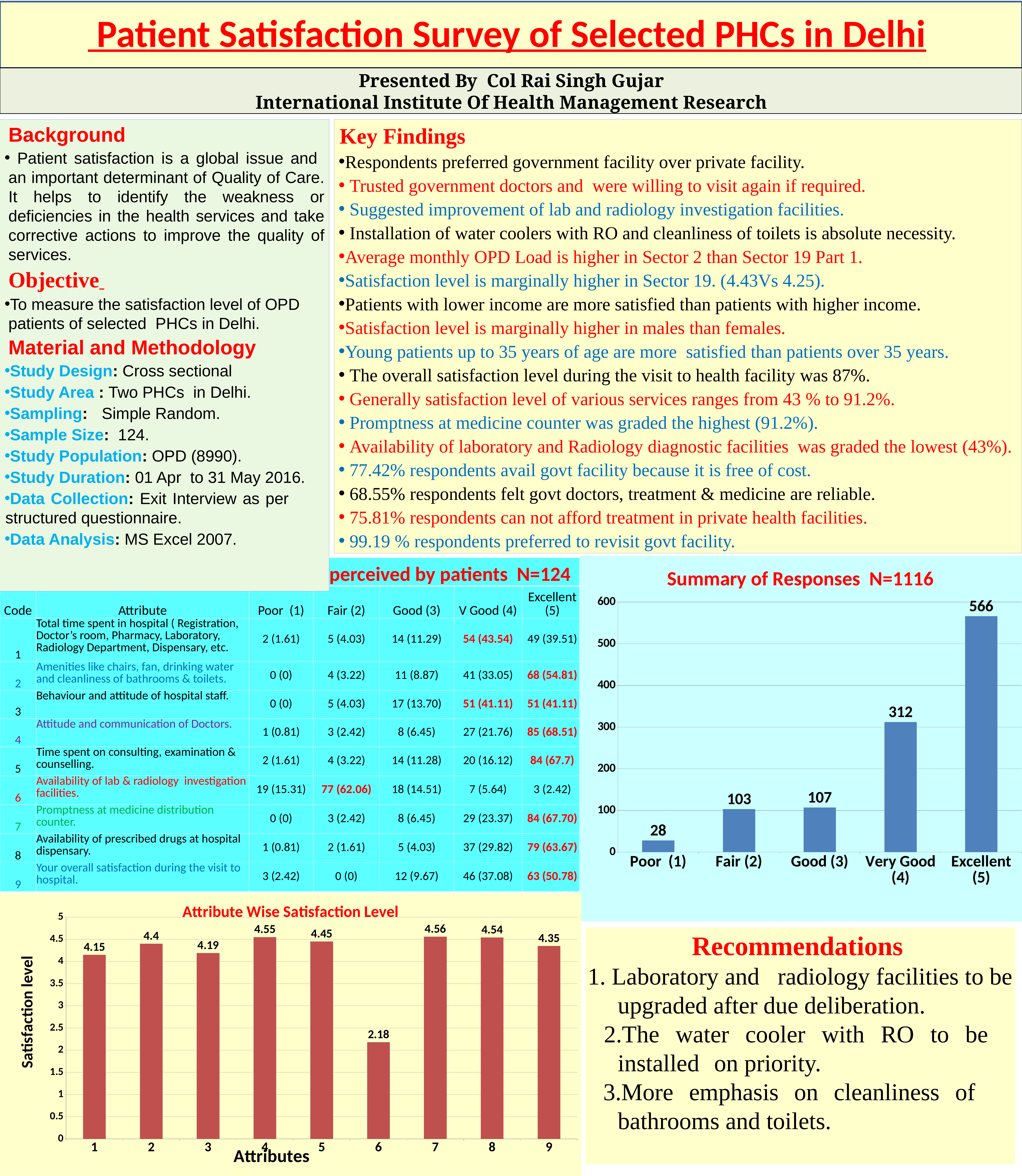
In the 'Attribute Wise Satisfaction Level' chart, which attribute has the lowest satisfaction level? 6 In the 'Attribute Wise Satisfaction Level' chart, what is the satisfaction level for attribute 6? 2.18 In the 'Summary of Responses N=1116' chart, which category has the lowest value? Poor (1) In the 'Summary of Responses N=1116' chart, what is the value for Excellent (5)? 566 In the 'Attribute Wise Satisfaction Level' chart, which is larger, the value for attribute 2 or attribute 3? attribute 2 In the 'Summary of Responses N=1116' chart, do the values rise or fall from Poor (1) to Excellent (5)? rise What type of chart is the 'Attribute Wise Satisfaction Level' chart? bar chart In the 'Summary of Responses N=1116' chart, is the value for Fair (2) greater or less than 100? greater In the 'Attribute Wise Satisfaction Level' chart, which attribute has the highest satisfaction level? 7 In the 'Summary of Responses N=1116' chart, what is the difference between Very Good (4) and Good (3)? 205 In the 'Attribute Wise Satisfaction Level' chart, what is the difference between attribute 4 and attribute 1? 0.4 In the 'Summary of Responses N=1116' chart, how many categories are shown on the x axis? 5